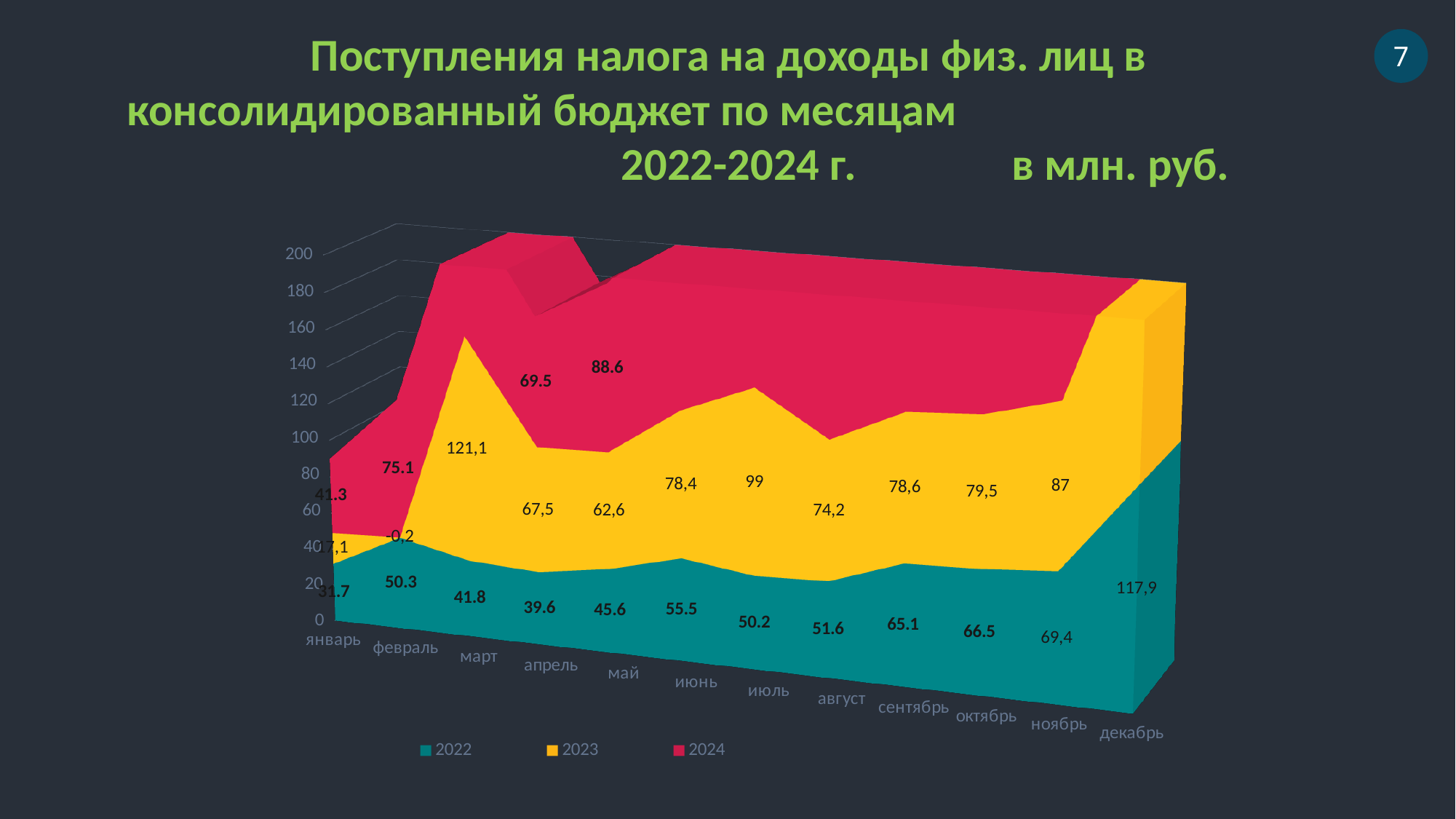
What is the value for 2022 in декабрь? 117,9 How many months are shown on the x axis? 12 Which colour represents the 2024 series in the legend? red What is the value for 2022 in июнь? 55.5 How many series does the legend list? 3 Which is larger for the 2023 series: июнь or июль? июль What is the difference between the 2022 values for декабрь and ноябрь? 48,5 What is the value for 2024 in февраль? 75.1 What is the value for 2023 in март? 121,1 Which month has the highest value for the 2022 series? декабрь What kind of chart is shown on the slide? area chart Which month has the lowest value for the 2023 series? февраль